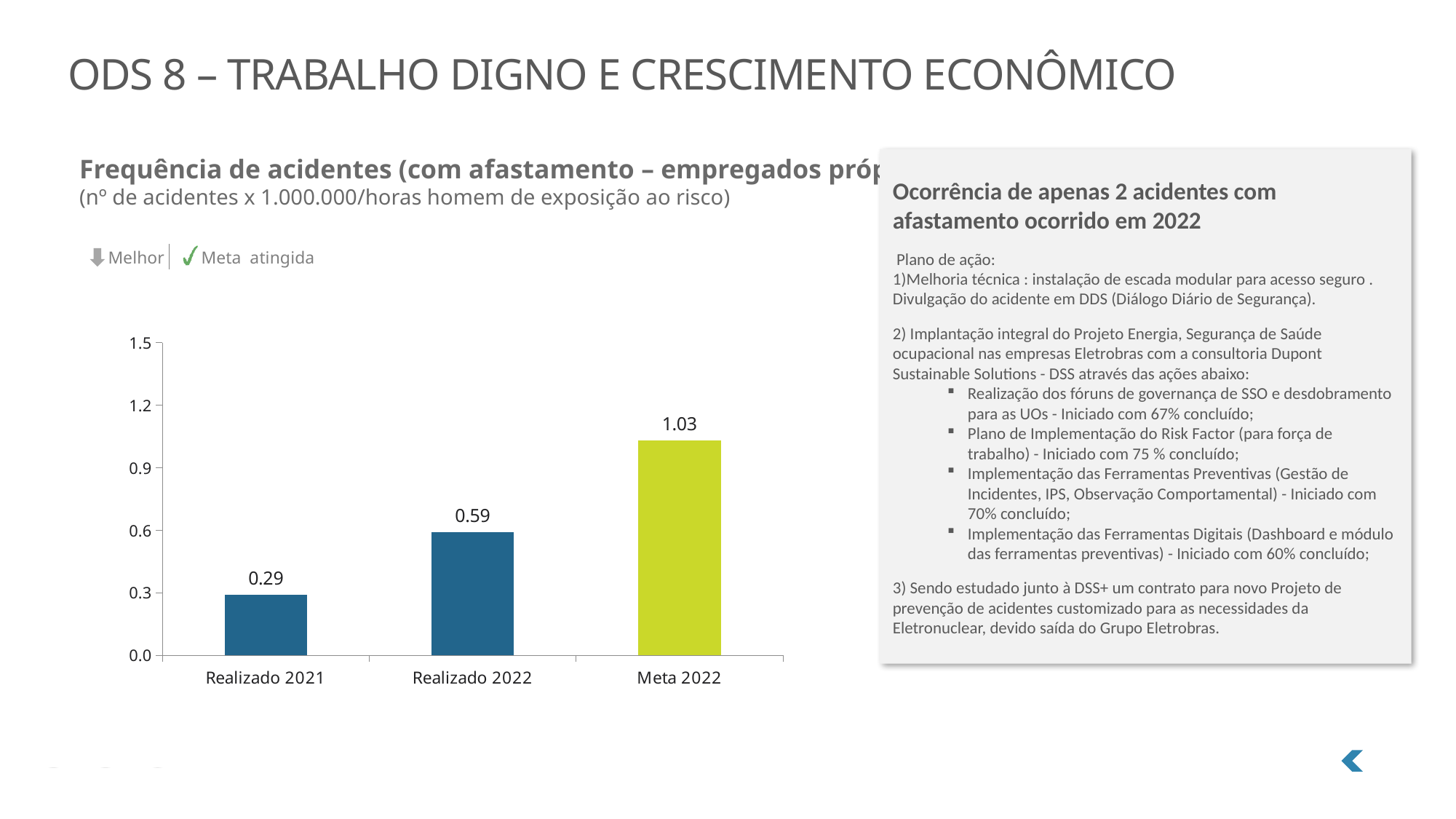
What is the value for Realizado 2021? 0.29 What is the difference between Realizado 2022 and Realizado 2021? 0.30 What kind of chart is shown on the slide? Bar chart How many bars are shown in the chart? 3 What is the value for Realizado 2022? 0.59 Which bar is coloured differently (yellow-green) from the others? Meta 2022 Is the value for Meta 2022 greater or less than 0.9? greater What is the difference between Meta 2022 and Realizado 2022? 0.44 Which is larger, Realizado 2021 or Realizado 2022? Realizado 2022 What is the value for Meta 2022? 1.03 Which category has the highest value? Meta 2022 Which category has the lowest value? Realizado 2021